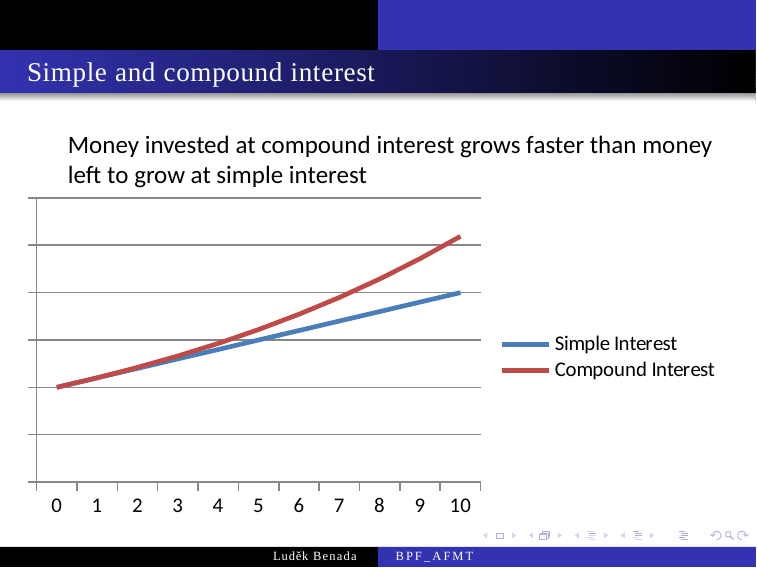
Which series reaches the highest point on the chart? Compound Interest At x = 10, which series has the higher value, Simple Interest or Compound Interest? Compound Interest Does the Simple Interest line rise or fall as x increases from 0 to 10? rise Which colour is used for the Compound Interest line? red How many tick labels are shown on the x axis? 11 Does the Compound Interest line rise or fall along the x axis? rise What is the largest value labelled on the x axis? 10 What are the two series named in the legend? Simple Interest and Compound Interest How many series does the legend list? 2 What kind of chart is shown on the slide? line chart